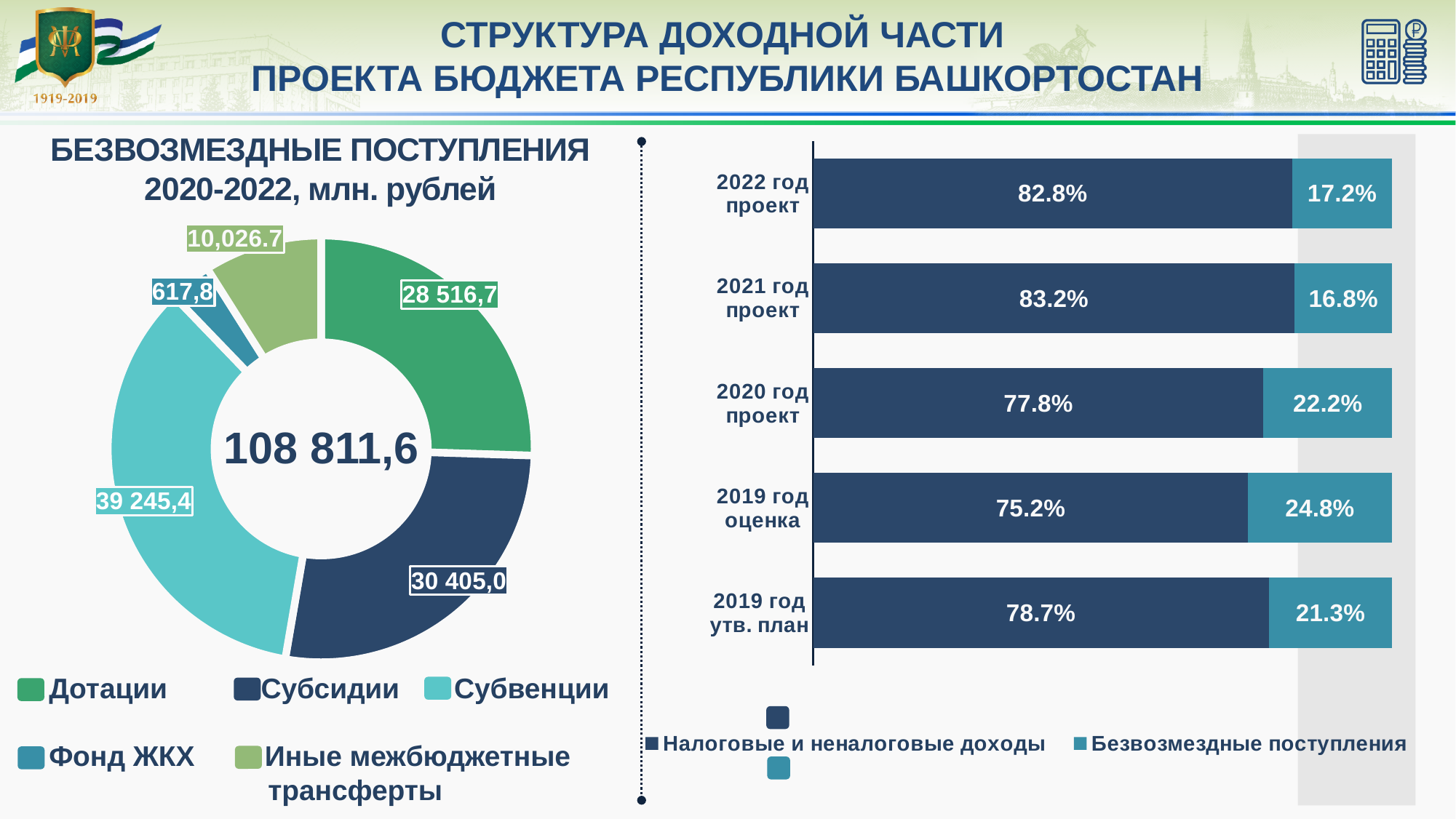
In the donut chart on the left, what is the value for Субвенции? 39 245,4 In the donut chart on the left, which is larger: Дотации or Субсидии? Субсидии In the bar chart on the right, what is the difference between the Безвозмездные поступления shares for 2020 год проект and 2022 год проект? 5.0% In the bar chart on the right, which period has the highest share of Налоговые и неналоговые доходы? 2021 год проект In the donut chart on the left, what total is shown in the centre? 108 811,6 In the bar chart on the right, what is the share of Налоговые и неналоговые доходы for 2021 год проект? 83.2% In the donut chart on the left, what is the value for Субсидии? 30 405,0 In the donut chart on the left, which category has the smallest value? Фонд ЖКХ In the donut chart on the left, which category has the largest value? Субвенции What kind of chart is shown on the right side of the slide? Stacked bar chart In the donut chart on the left, how many categories does the legend list? 5 In the bar chart on the right, what is the share of Безвозмездные поступления for 2019 год оценка? 24.8%